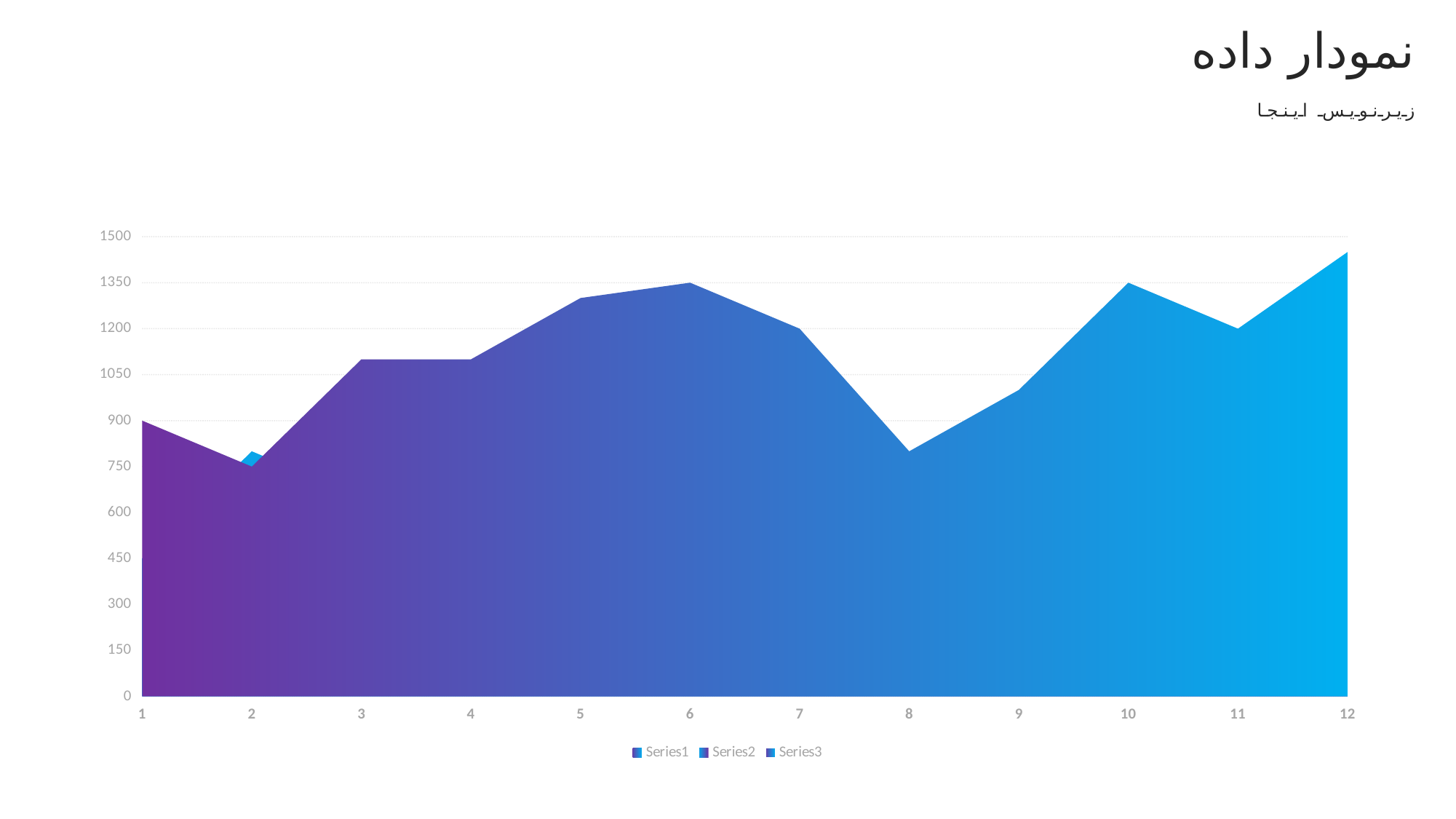
At which x-axis category does the plotted area reach its highest point? 12 Is the value plotted at category 9 greater or less than 1050? less Do the plotted values rise or fall from category 8 to category 10? rise Is the value plotted at category 5 greater or less than 1200? greater Is the value plotted at category 8 greater or less than 900? less What kind of chart is shown on the slide? area chart How many categories are shown along the x axis of the chart? 12 What are the names of the series listed in the chart legend? Series1, Series2, Series3 Which is larger, the value plotted at category 6 or at category 8? category 6 How many series does the chart legend list? 3